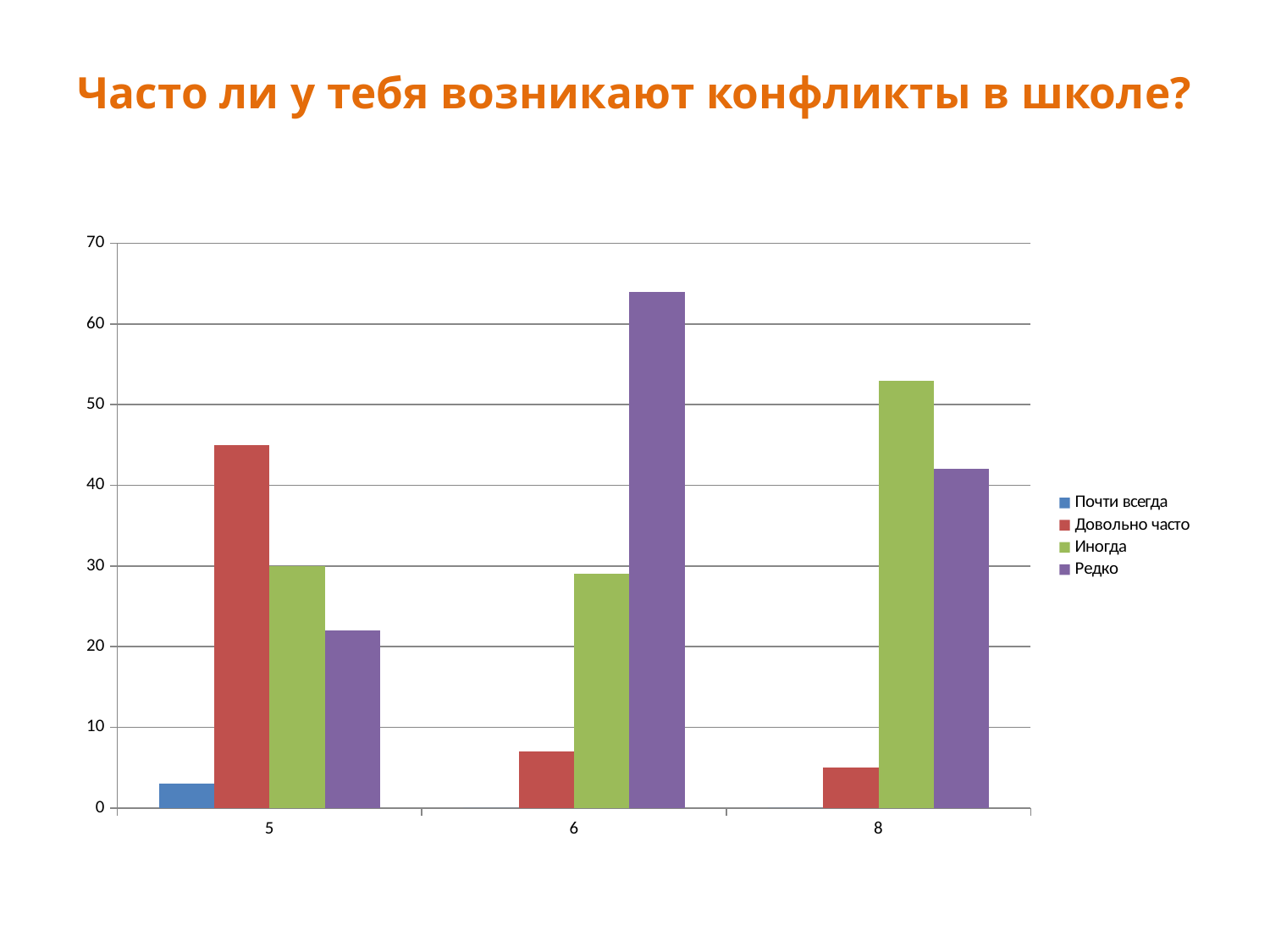
Is the value for Довольно часто in category 8 greater or less than 10? less Which series has the highest value for category 6? Редко For category 8, which is larger: Иногда or Редко? Иногда What is the title of the chart? Часто ли у тебя возникают конфликты в школе? Which series is shown in purple in the legend? Редко Is the value for Редко in category 6 greater or less than 60? greater What kind of chart is shown on the slide? bar chart Which series has the highest value for category 5? Довольно часто How many series does the legend list? 4 In which category does the Почти всегда series appear? 5 How many categories are shown on the x axis? 3